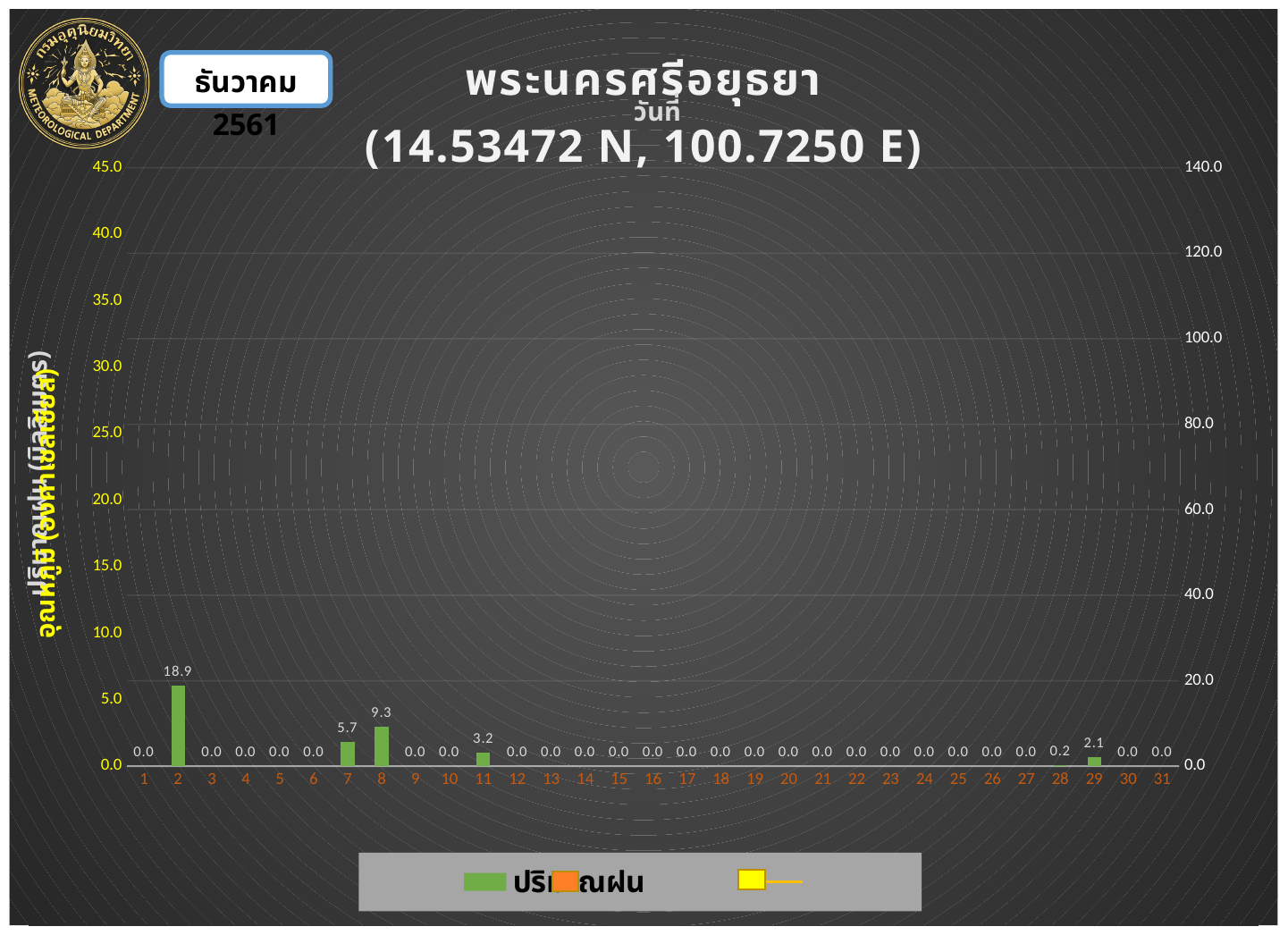
What is the difference between the rainfall values for day 7 and day 11? 2.5 What kind of chart is shown on the slide? bar chart What is the rainfall value for day 8? 9.3 How many days are shown on the x axis? 31 Which day has the highest rainfall value? 2 What is the rainfall value for day 7? 5.7 Which has the larger rainfall value, day 7 or day 8? day 8 What is the rainfall value for day 11? 3.2 What is the rainfall value for day 2? 18.9 What is the difference between the rainfall values for day 2 and day 8? 9.6 What is the rainfall value for day 29? 2.1 What is the rainfall value for day 28? 0.2